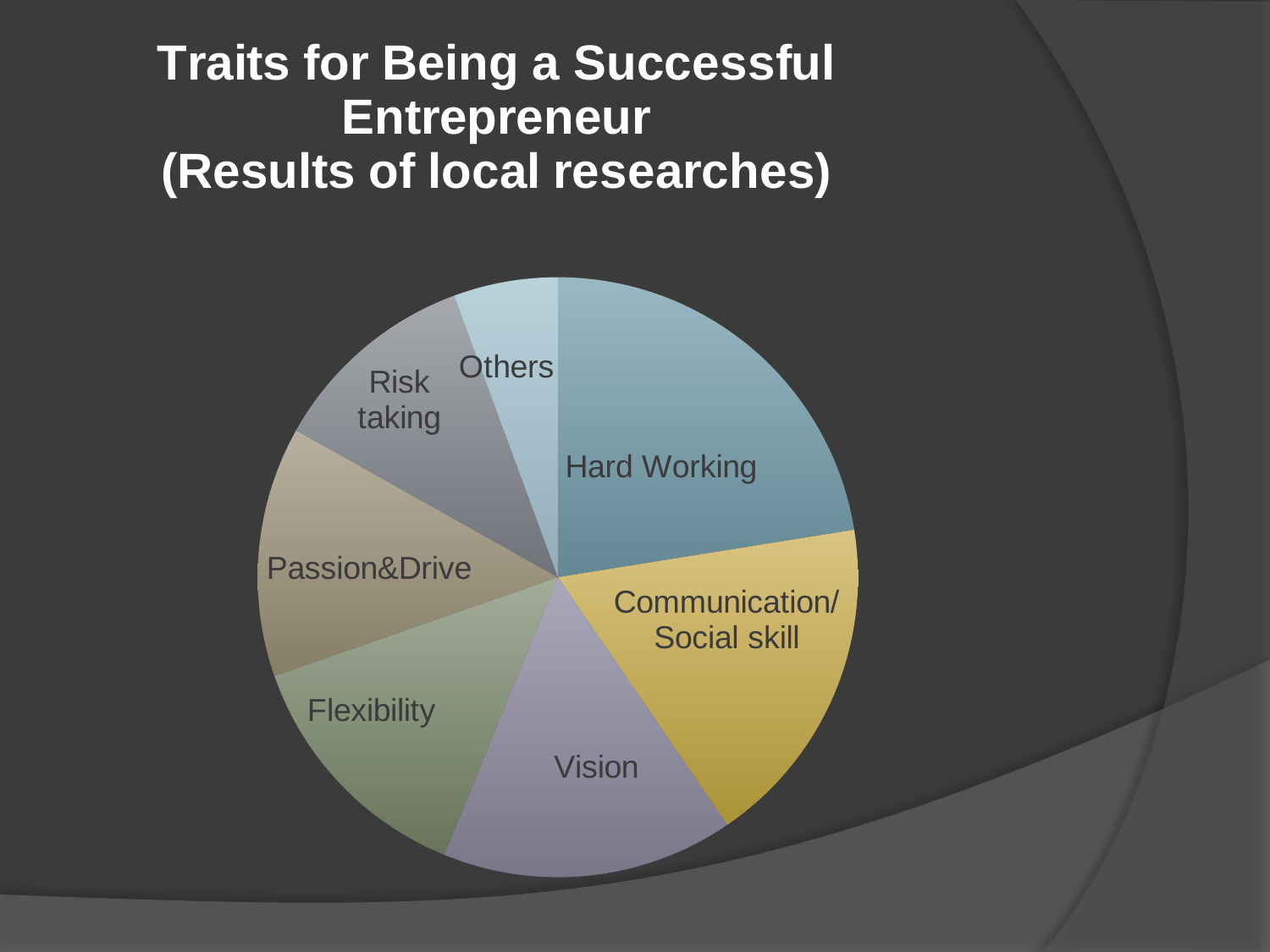
Which slice is larger, Passion&Drive or Others? Passion&Drive Which slice is larger, Hard Working or Communication/Social skill? Hard Working Which trait has the largest slice of the pie chart? Hard Working What kind of chart is shown on the slide? pie chart What is the title of the slide containing the pie chart? Traits for Being a Successful Entrepreneur (Results of local researches) Which slice is larger, Hard Working or Risk taking? Hard Working Which trait is shown in the yellow slice of the pie chart? Communication/Social skill Which slice of the pie chart is the smallest? Others How many slices does the pie chart have? 7